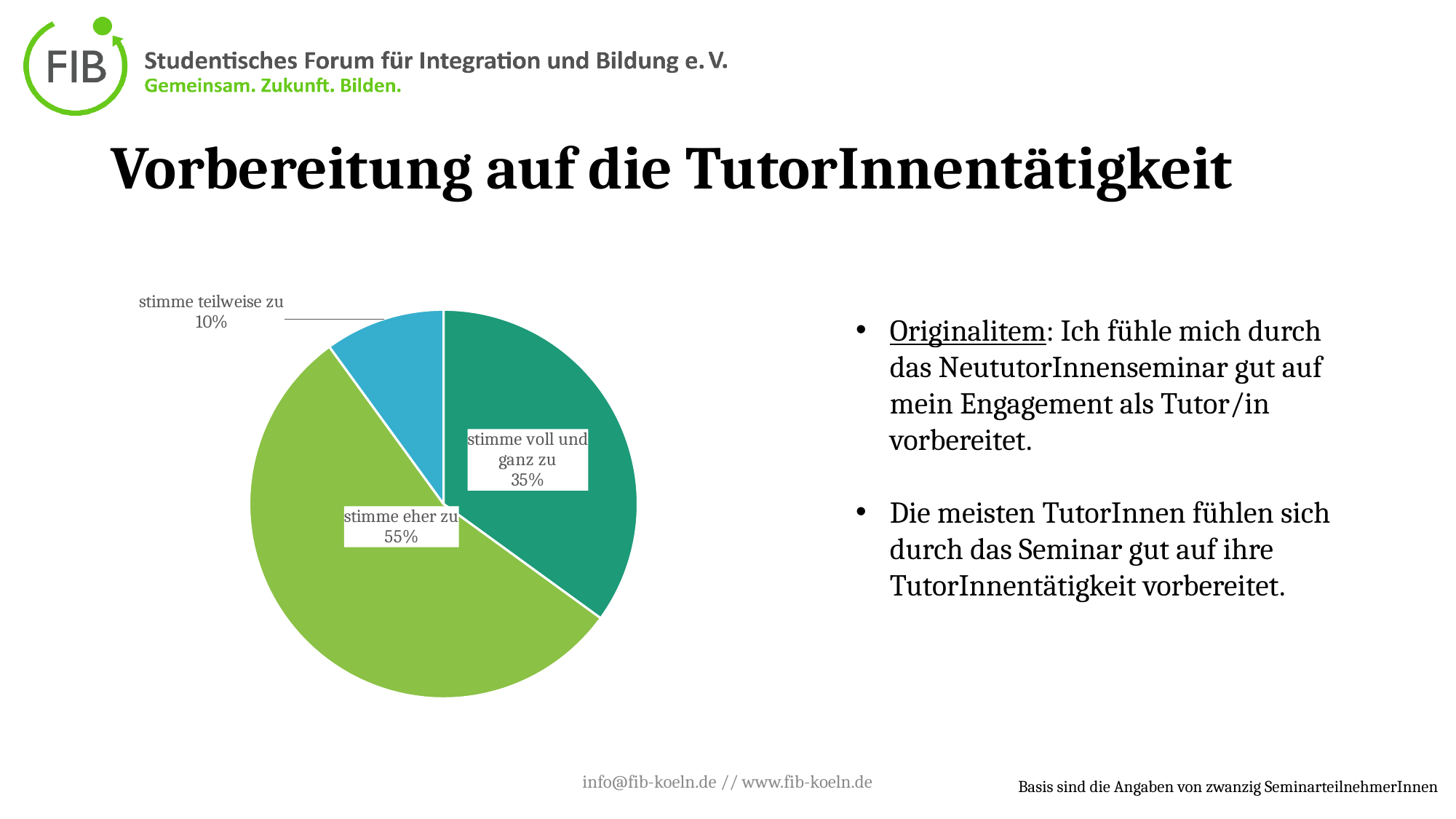
What colour is the slice for "stimme eher zu"? light green Which category has the largest slice of the pie? stimme eher zu What is the difference in percentage points between "stimme eher zu" and "stimme voll und ganz zu"? 20 percentage points Which is larger: the slice for "stimme voll und ganz zu" or the slice for "stimme teilweise zu"? stimme voll und ganz zu What share of the pie does "stimme voll und ganz zu" have? 35% Which category has the smallest slice of the pie? stimme teilweise zu What share of the pie does "stimme teilweise zu" have? 10% What colour is the slice for "stimme teilweise zu"? blue What is the difference in percentage points between "stimme voll und ganz zu" and "stimme teilweise zu"? 25 percentage points What kind of chart is shown on the slide? pie chart How many slices does the pie chart have? 3 What share of the pie does "stimme eher zu" have? 55%